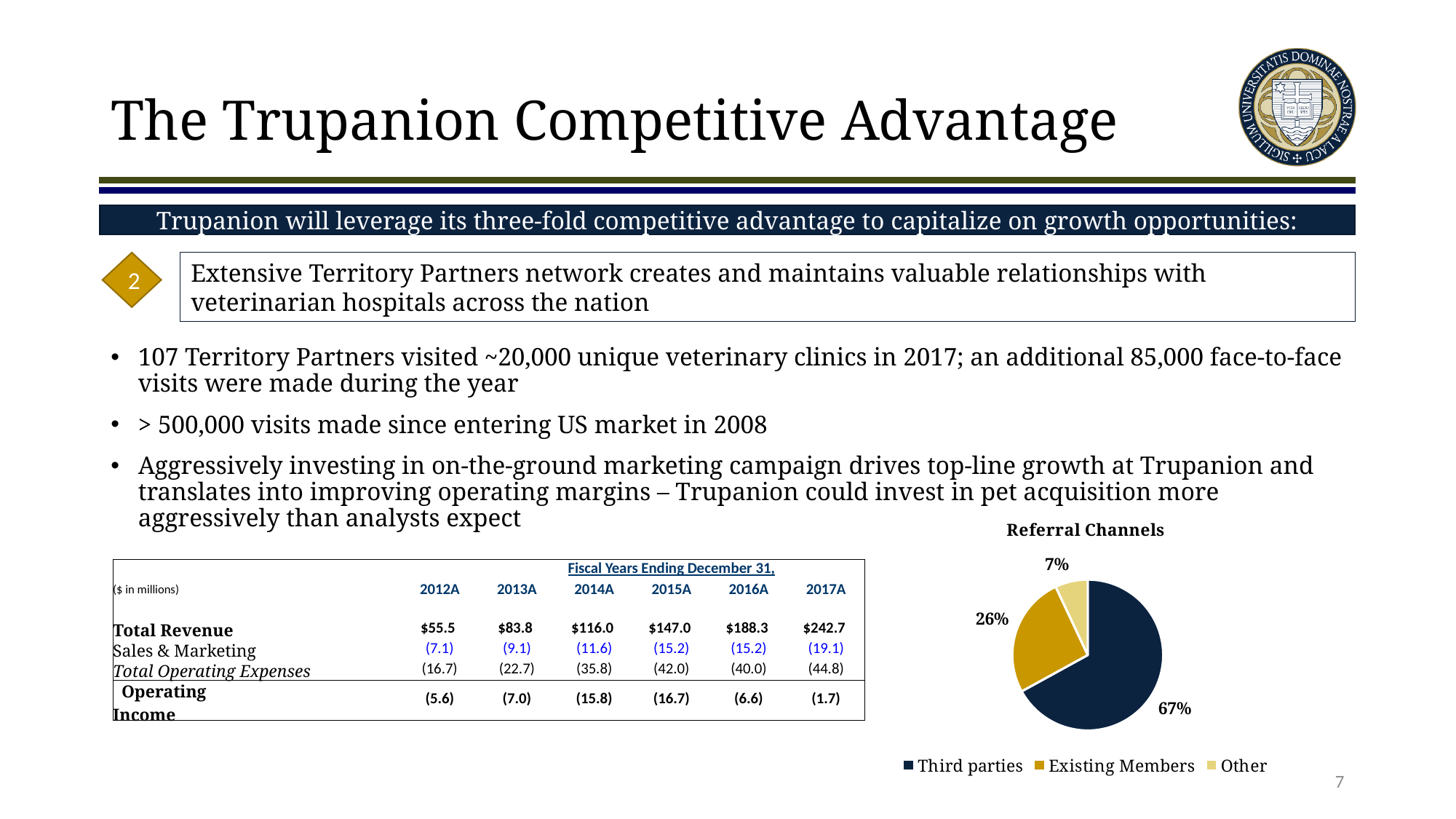
How many entries does the legend of the Referral Channels chart list? 3 What type of chart is the Referral Channels chart? pie chart What is the title of the pie chart on the slide? Referral Channels Which referral channel has the smallest share in the Referral Channels chart? Other Which referral channel has the largest share in the Referral Channels chart? Third parties In the Referral Channels chart, how many percentage points larger is the Third parties share than the Existing Members share? 41 In the Referral Channels chart, which is larger: the share for Existing Members or the share for Other? Existing Members In the Referral Channels chart, what colour is the Existing Members slice? gold In the Referral Channels chart, what share does Other account for? 7% In the Referral Channels chart, what share do Existing Members account for? 26% How many slices does the Referral Channels pie chart have? 3 In the Referral Channels chart, what share do Third parties account for? 67%